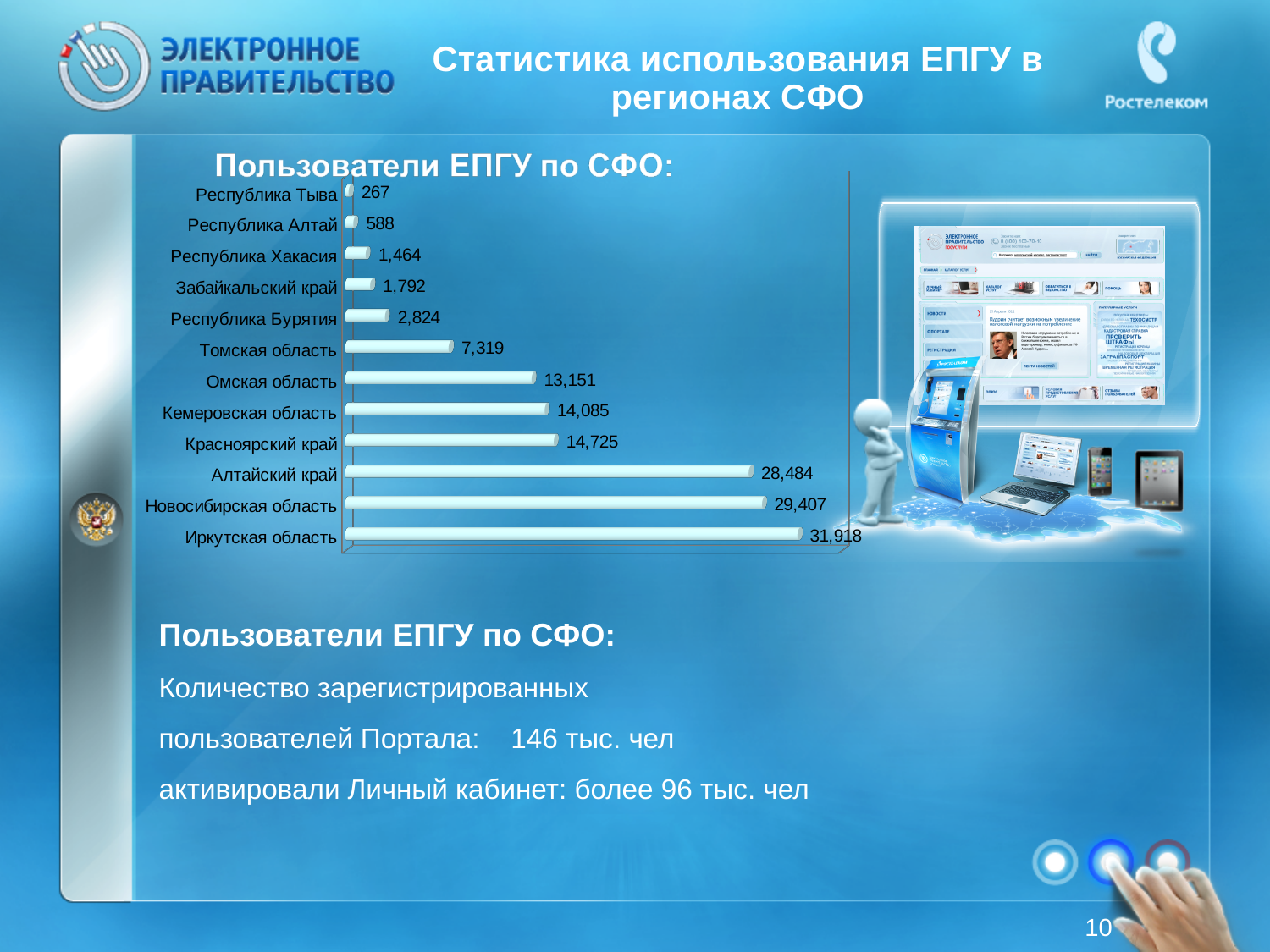
What is the value for Республика Хакасия? 1,464 Which is larger, the value for Омская область or the value for Томская область? Омская область Which region has the highest value? Иркутская область What is the title of the chart? Пользователи ЕПГУ по СФО: Which region has the lowest value? Республика Тыва What is the value for Иркутская область? 31,918 What is the value for Томская область? 7,319 What is the value for Республика Бурятия? 2,824 What is the difference between the values for Красноярский край and Кемеровская область? 640 What kind of chart is shown on the slide? Bar chart What is the difference between the values for Новосибирская область and Алтайский край? 923 How many regions are shown in the chart? 12